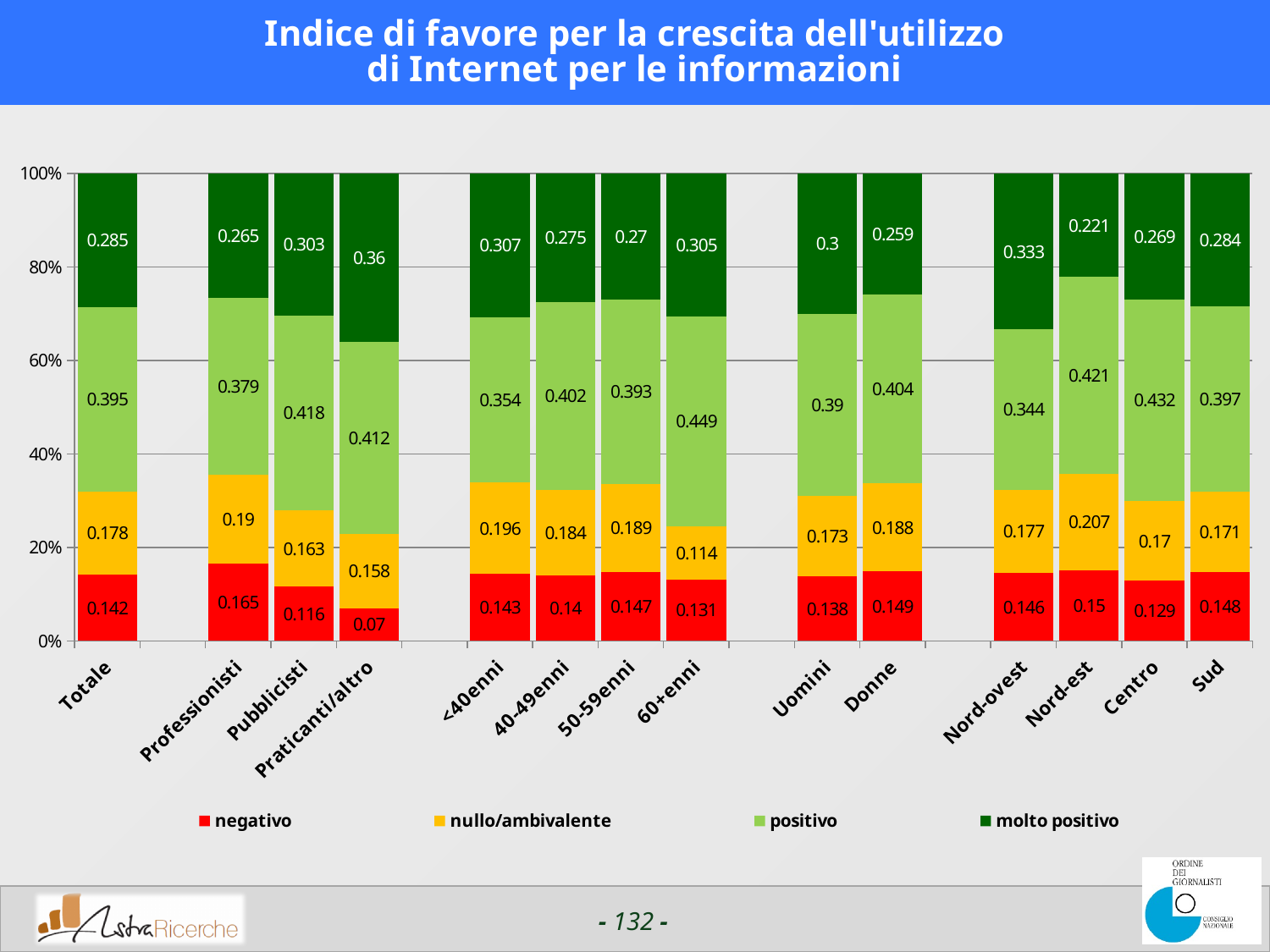
Which category has the lowest 'nullo/ambivalente' value? 60+enni What is the value of the 'molto positivo' series for Praticanti/altro? 0.36 How many series does the legend list? 4 What is the 'nullo/ambivalente' value for Nord-est? 0.207 Which category has the lowest 'negativo' value? Praticanti/altro Which has the larger 'negativo' value, Uomini or Donne? Donne What kind of chart is shown on the slide? Stacked bar chart How many categories are shown on the x axis? 14 What is the 'positivo' value for 60+enni? 0.449 Which category has the highest 'molto positivo' value? Praticanti/altro What is the difference between the 'molto positivo' value for Praticanti/altro and for Totale? 0.075 What is the 'negativo' value for Donne? 0.149